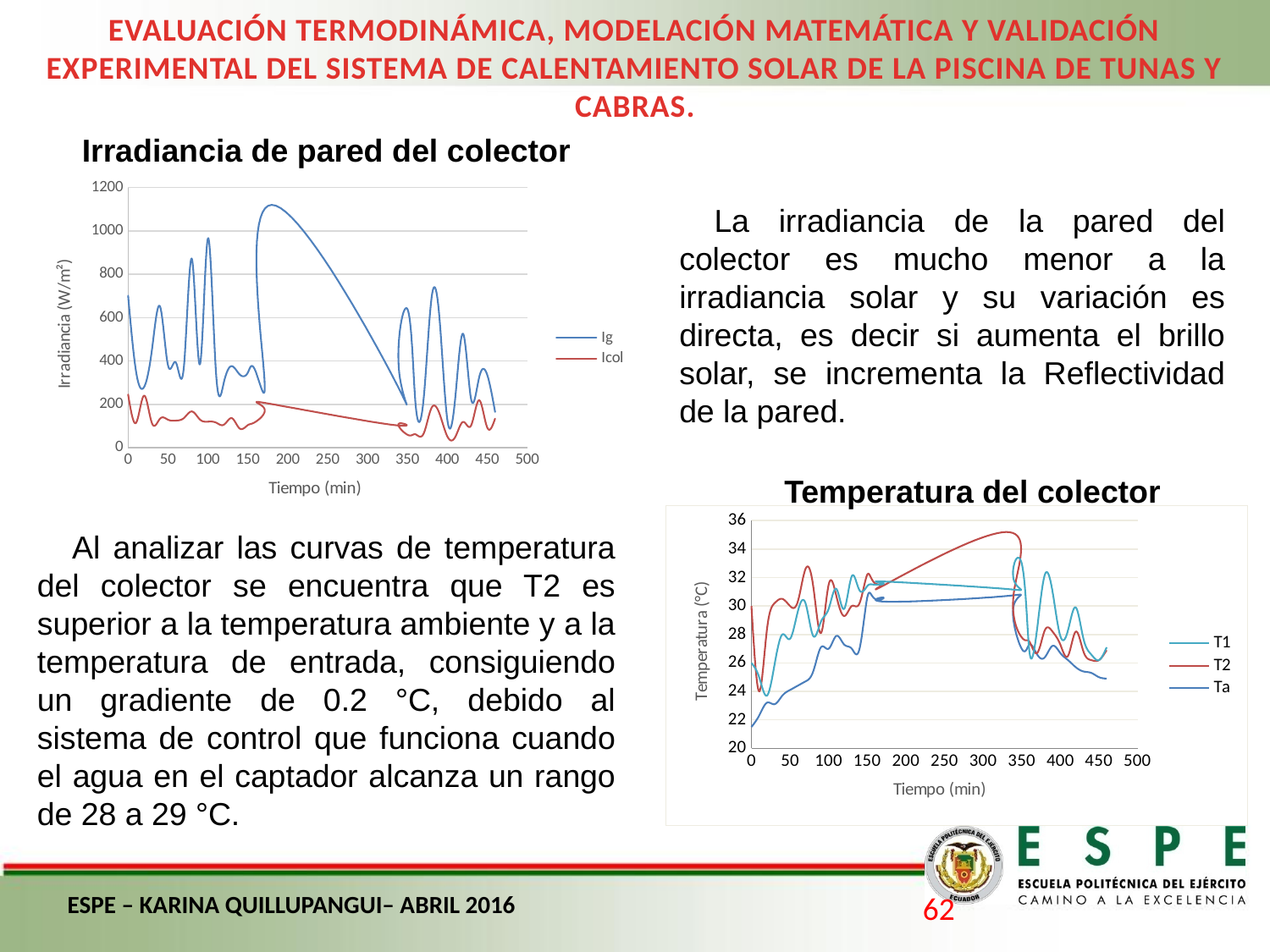
In the 'Irradiancia de pared del colector' chart, which series reaches the higher values, Ig or Icol? Ig What is the y-axis title of the 'Temperatura del colector' chart? Temperatura (°C) In the 'Temperatura del colector' chart, is the peak value of T2 greater or less than 34? greater What kind of chart is the 'Irradiancia de pared del colector' chart? line chart In the 'Temperatura del colector' chart, which series reaches the highest temperature? T2 How many series does the legend of the 'Temperatura del colector' chart list? 3 What kind of chart is the 'Temperatura del colector' chart? line chart How many series does the legend of the 'Irradiancia de pared del colector' chart list? 2 In the 'Temperatura del colector' chart, is the value of Ta at time 0 greater or less than 24? less In the 'Irradiancia de pared del colector' chart, is the highest value of Icol greater or less than 400? less What is the x-axis title of the 'Irradiancia de pared del colector' chart? Tiempo (min)